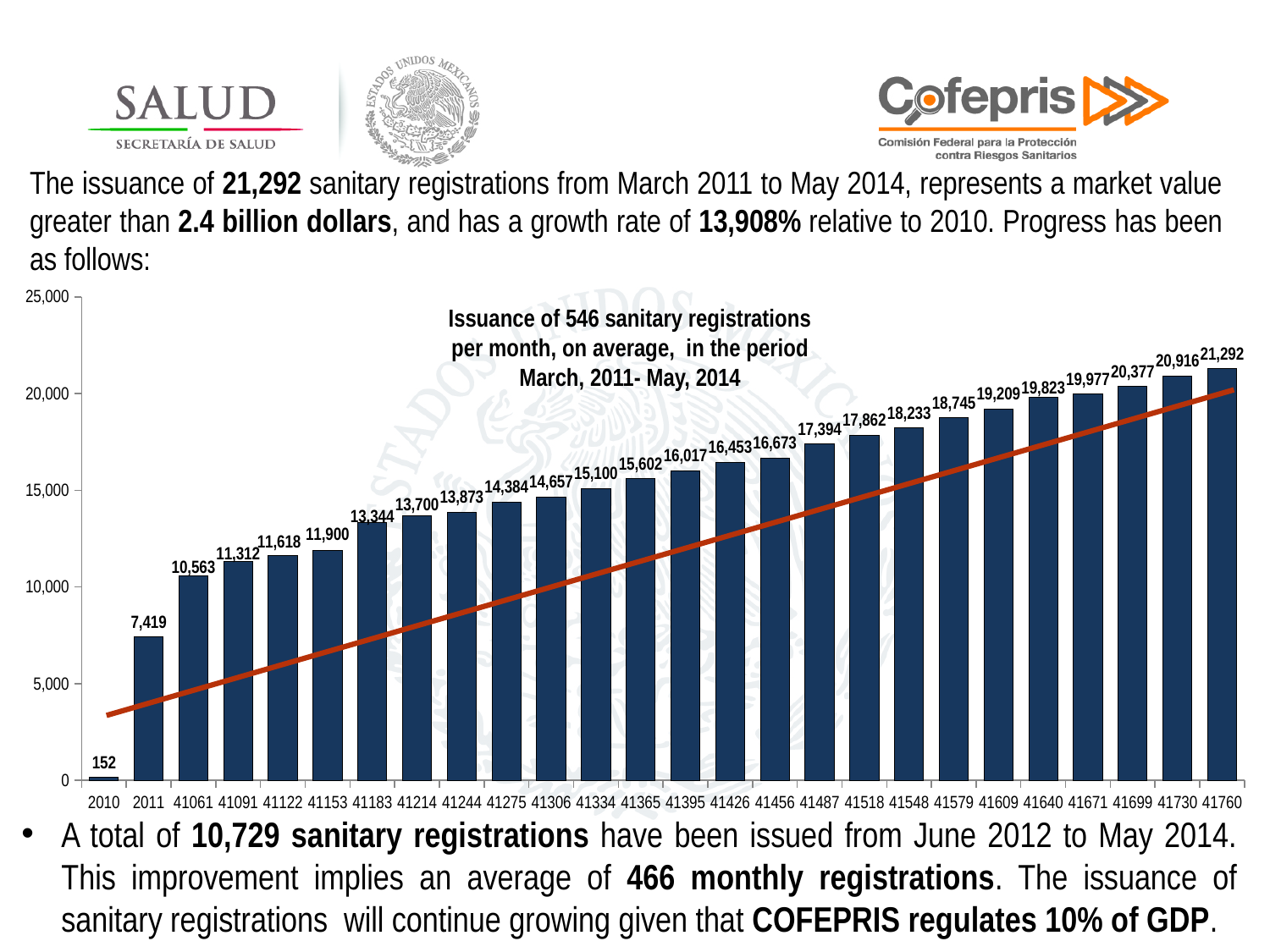
What is the value of the bar labelled 41306? 14,657 What is the difference between the values for 41760 and 41730? 376 What is the difference between the values for 2011 and 2010? 7,267 What kind of chart is shown on the slide? bar chart What is the value of the bar labelled 41760? 21,292 What is the value of the bar labelled 2010? 152 What is the value of the bar labelled 2011? 7,419 Which category has the highest bar? 41760 How many bars are plotted in the chart? 26 Which is larger, the value for 41183 or the value for 41153? 41183 Is the value for 41487 greater or less than 15,000? greater Which category has the lowest bar? 2010